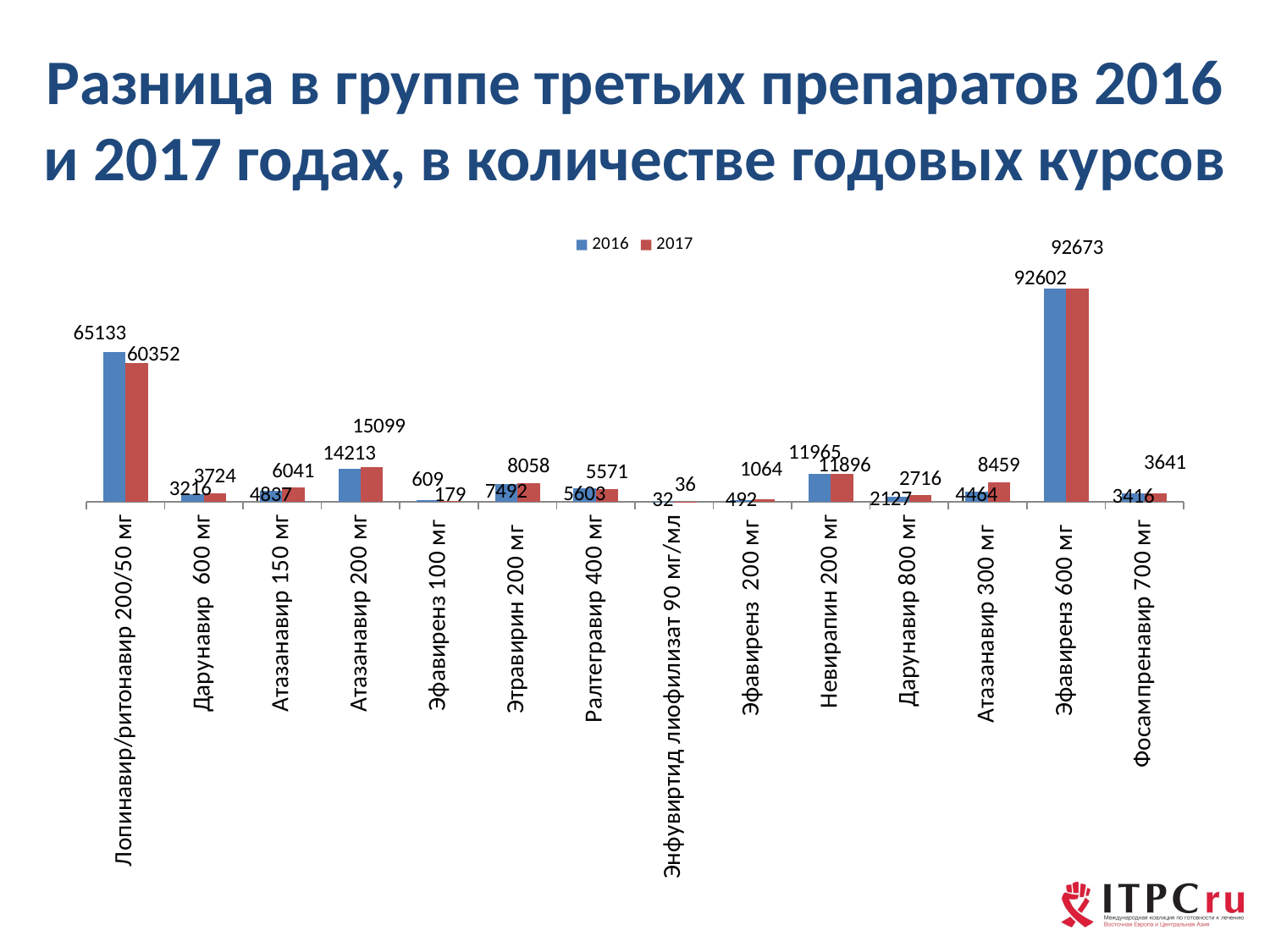
By how much did the value for Лопинавир/ритонавир 200/50 мг decrease from 2016 to 2017? 4781 How many drug categories are shown on the x axis? 14 Which category has the highest 2017 value? Эфавиренз 600 мг Which category has the lowest 2016 value? Энфувиртид лиофилизат 90 мг/мл What are the two entries in the legend? 2016 and 2017 What is the 2017 value for Эфавиренз 200 мг? 1064 What is the 2017 value for Атазанавир 300 мг? 8459 What kind of chart is shown on the slide? bar chart For Атазанавир 300 мг, which year has the larger value, 2016 or 2017? 2017 How many series does the legend list? 2 What is the 2016 value for Лопинавир/ритонавир 200/50 мг? 65133 What is the 2016 value for Невирапин 200 мг? 11965